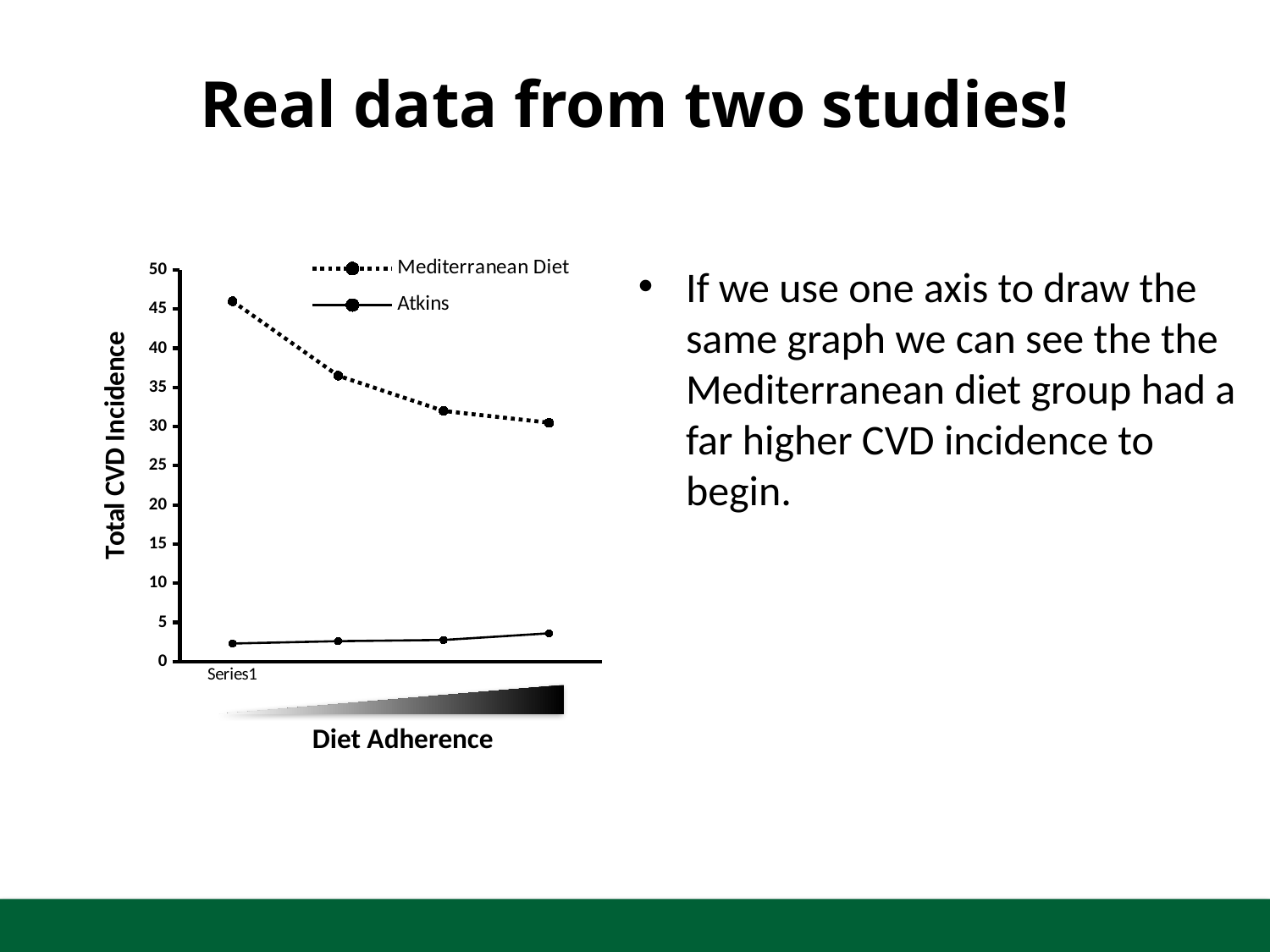
Do the values for the Mediterranean Diet series rise or fall along the x axis? fall What kind of chart is shown on the slide? line chart What is the title of the vertical axis? Total CVD Incidence Is the second value for the Mediterranean Diet series greater or less than 40? less Is the last value for the Mediterranean Diet series greater or less than 35? less Do the values for the Atkins series rise or fall along the x axis? rise How many data points are plotted for the Mediterranean Diet series? 4 How many series does the legend list? 2 Is the first value for the Atkins series greater or less than 5? less Which series has the higher value at the first point on the x axis, Mediterranean Diet or Atkins? Mediterranean Diet Which series is drawn with a dotted line? Mediterranean Diet